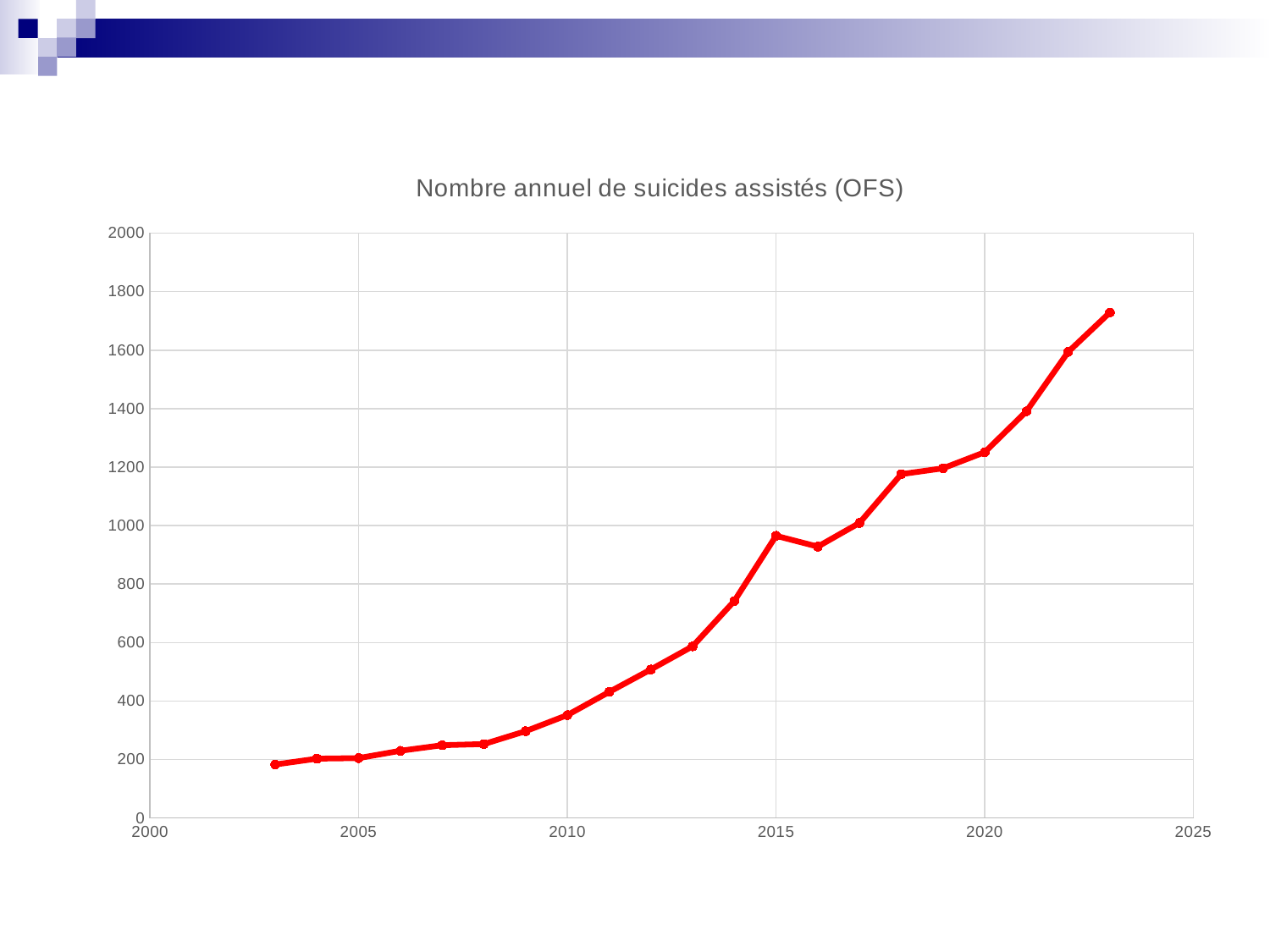
How many data points are plotted on the line? 21 What is the highest value shown on the vertical axis? 2000 Which year has the lowest value? 2003 What kind of chart is shown on the slide? line chart Is the value for 2005 greater or less than 400? less Which year has the highest value? 2023 Is the value for 2023 greater or less than 1600? greater Which is larger, the value for 2015 or the value for 2014? 2015 Is the value for 2018 greater or less than 1000? greater What is the title of the chart? Nombre annuel de suicides assistés (OFS) Do the values generally rise or fall from 2003 to 2023? rise